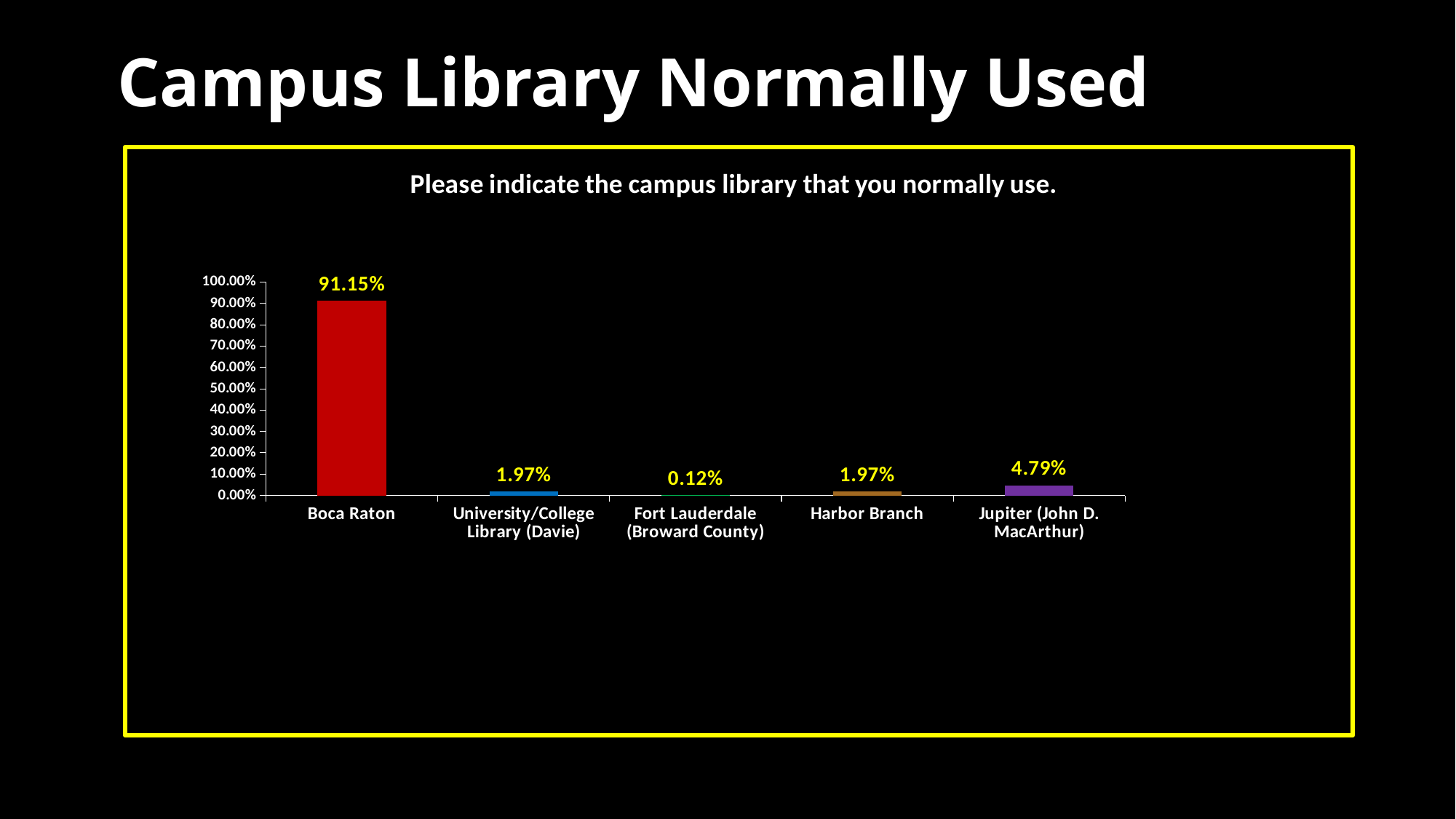
What kind of chart is shown on the slide? Bar chart What is the title of the chart inside the yellow box? Please indicate the campus library that you normally use. How many campus libraries are shown on the chart? 5 What is the value shown for Fort Lauderdale (Broward County)? 0.12% Which is larger, the value for Jupiter (John D. MacArthur) or the value for Harbor Branch? Jupiter (John D. MacArthur) What is the difference between the Boca Raton value and the Jupiter (John D. MacArthur) value? 86.36% What is the value shown for Harbor Branch? 1.97% What percentage of respondents normally use the Boca Raton library? 91.15% Is the value for Boca Raton greater or less than 90.00%? greater Which campus library has the lowest percentage? Fort Lauderdale (Broward County) What is the value shown for Jupiter (John D. MacArthur)? 4.79% Which campus library has the highest percentage? Boca Raton